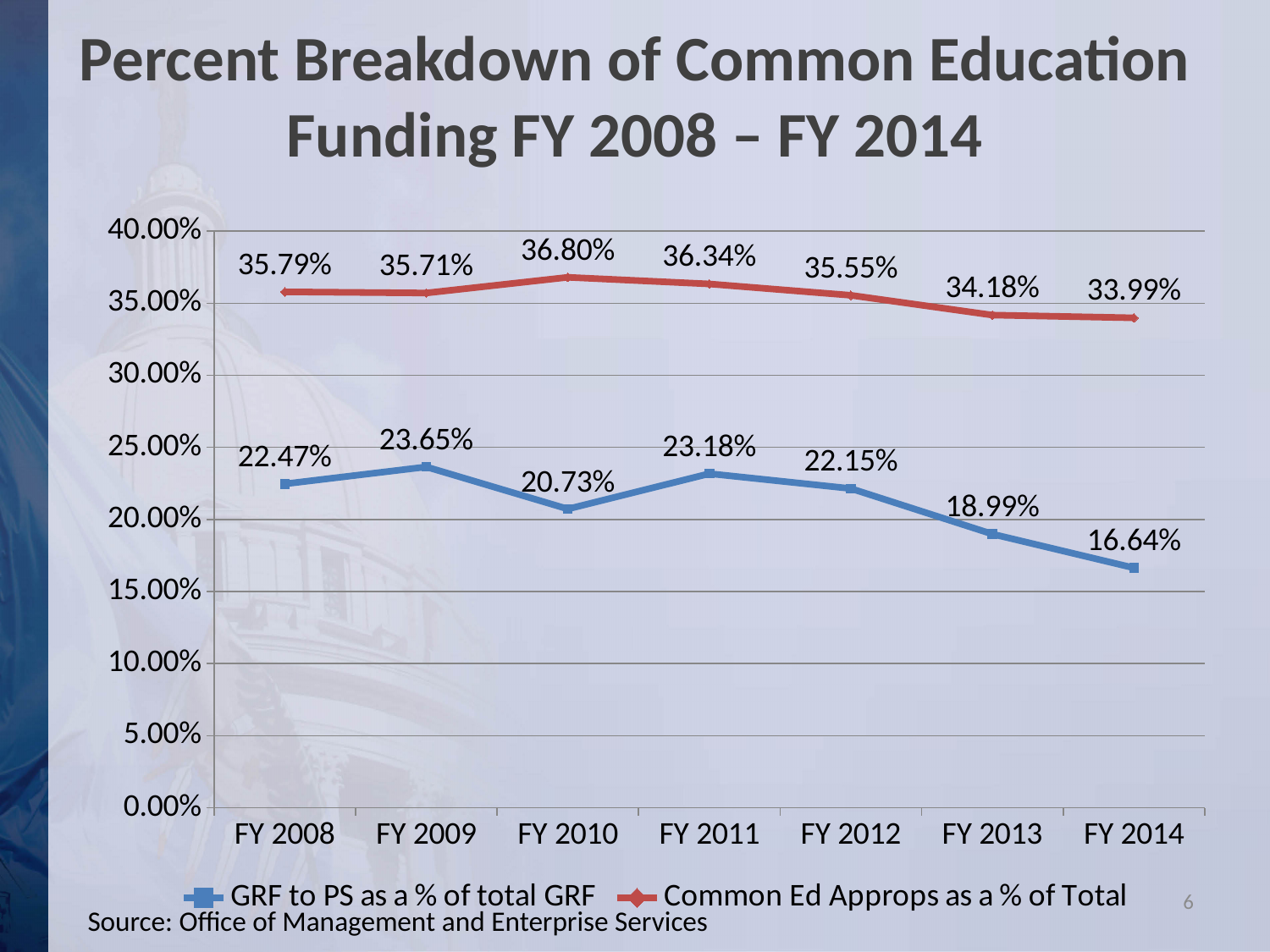
How many fiscal years are shown on the x axis? 7 How many series does the legend list? 2 Which is larger for "GRF to PS as a % of total GRF": FY 2009 or FY 2011? FY 2009 What is the value of "Common Ed Approps as a % of Total" for FY 2012? 35.55% What kind of chart is shown on the slide? line chart In which fiscal year is "GRF to PS as a % of total GRF" lowest? FY 2014 What colour is the line for "Common Ed Approps as a % of Total"? red Is the value of "GRF to PS as a % of total GRF" for FY 2013 greater or less than 20.00%? less From FY 2011 to FY 2014, does "GRF to PS as a % of total GRF" rise or fall? fall What is the difference between the two series' values in FY 2014? 17.35% In which fiscal year is "Common Ed Approps as a % of Total" highest? FY 2010 What is the value of "GRF to PS as a % of total GRF" for FY 2010? 20.73%